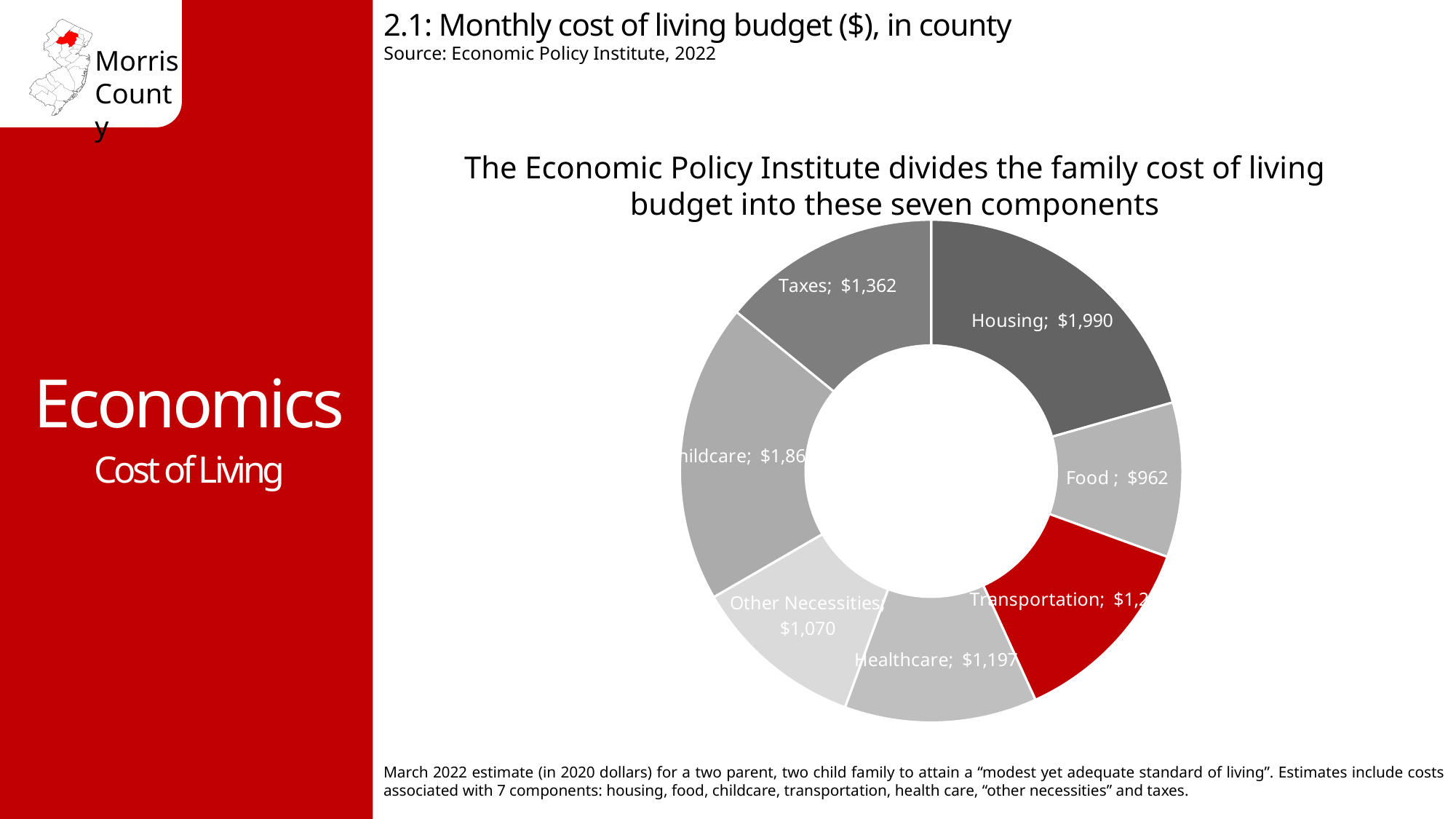
What type of chart is shown on the slide? Doughnut (pie) chart What is the monthly cost for Other Necessities? $1,070 What is the monthly cost for Housing? $1,990 Which component has the lowest monthly cost? Food What is the difference between the Housing cost and the Taxes cost? $628 Which is larger, the cost for Taxes or the cost for Healthcare? Taxes What is the monthly cost for Taxes? $1,362 Which component has the highest monthly cost? Housing What is the monthly cost for Healthcare? $1,197 What is the monthly cost for Food? $962 How many components are shown in the chart? 7 Which component's slice is coloured red in the chart? Transportation